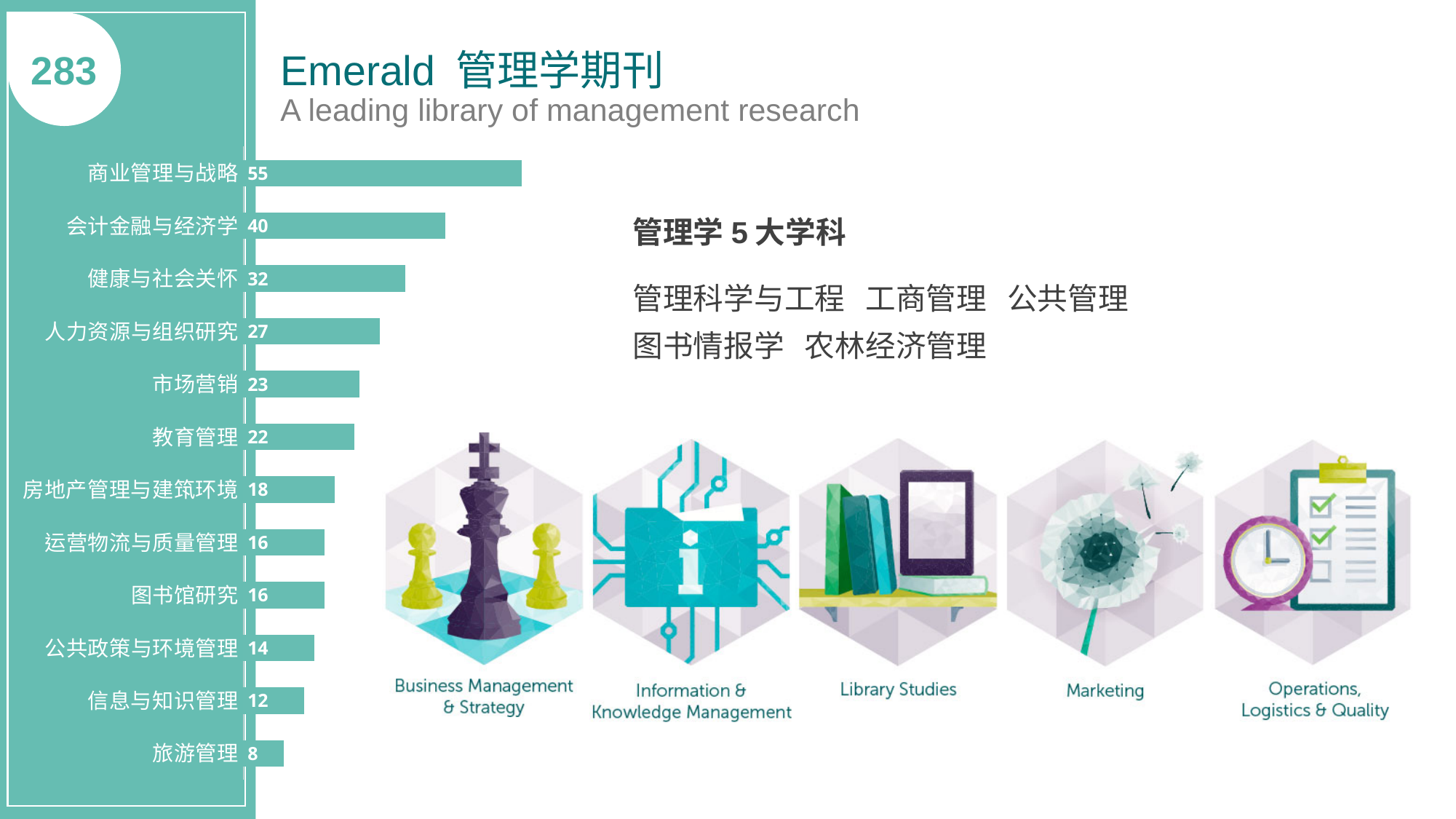
What is the value for 公共政策与环境管理? 14 What is the difference between the values for 商业管理与战略 and 会计金融与经济学? 15 What kind of chart is shown on the left of the slide? Bar chart How many categories are shown in the bar chart? 12 Which is larger, the value for 房地产管理与建筑环境 or the value for 信息与知识管理? 房地产管理与建筑环境 What is the difference between the values for 健康与社会关怀 and 旅游管理? 24 Which category has the highest value? 商业管理与战略 What is the value for 市场营销? 23 Which category has the lowest value? 旅游管理 Do the values rise or fall going from the top category to the bottom category? Fall Which is larger, the value for 人力资源与组织研究 or the value for 教育管理? 人力资源与组织研究 What is the value for 商业管理与战略? 55